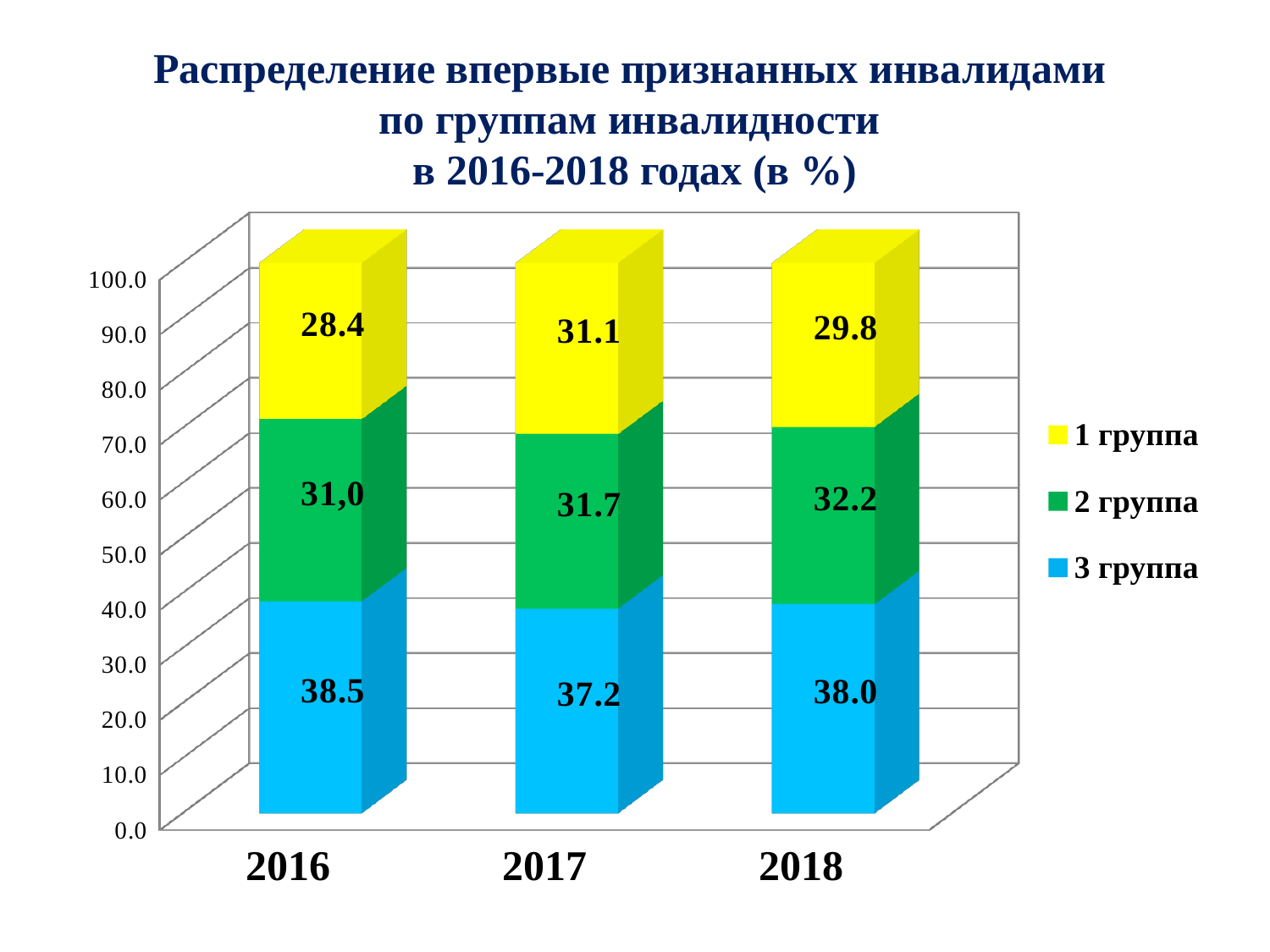
In which year is the value for 1 группа highest? 2017 Which colour represents 2 группа in the legend? Green In which year is the value for 3 группа lowest? 2017 What is the value for 1 группа in 2017? 31.1 What is the difference between the 3 группа value in 2016 and in 2017? 1.3 What is the value for 3 группа in 2016? 38.5 How many series does the legend list? 3 What is the value for 2 группа in 2018? 32.2 How many years are shown on the x axis? 3 Which is larger in 2018: the value for 1 группа or the value for 3 группа? 3 группа What is the value for 2 группа in 2016? 31,0 What kind of chart is shown on the slide? Stacked bar chart